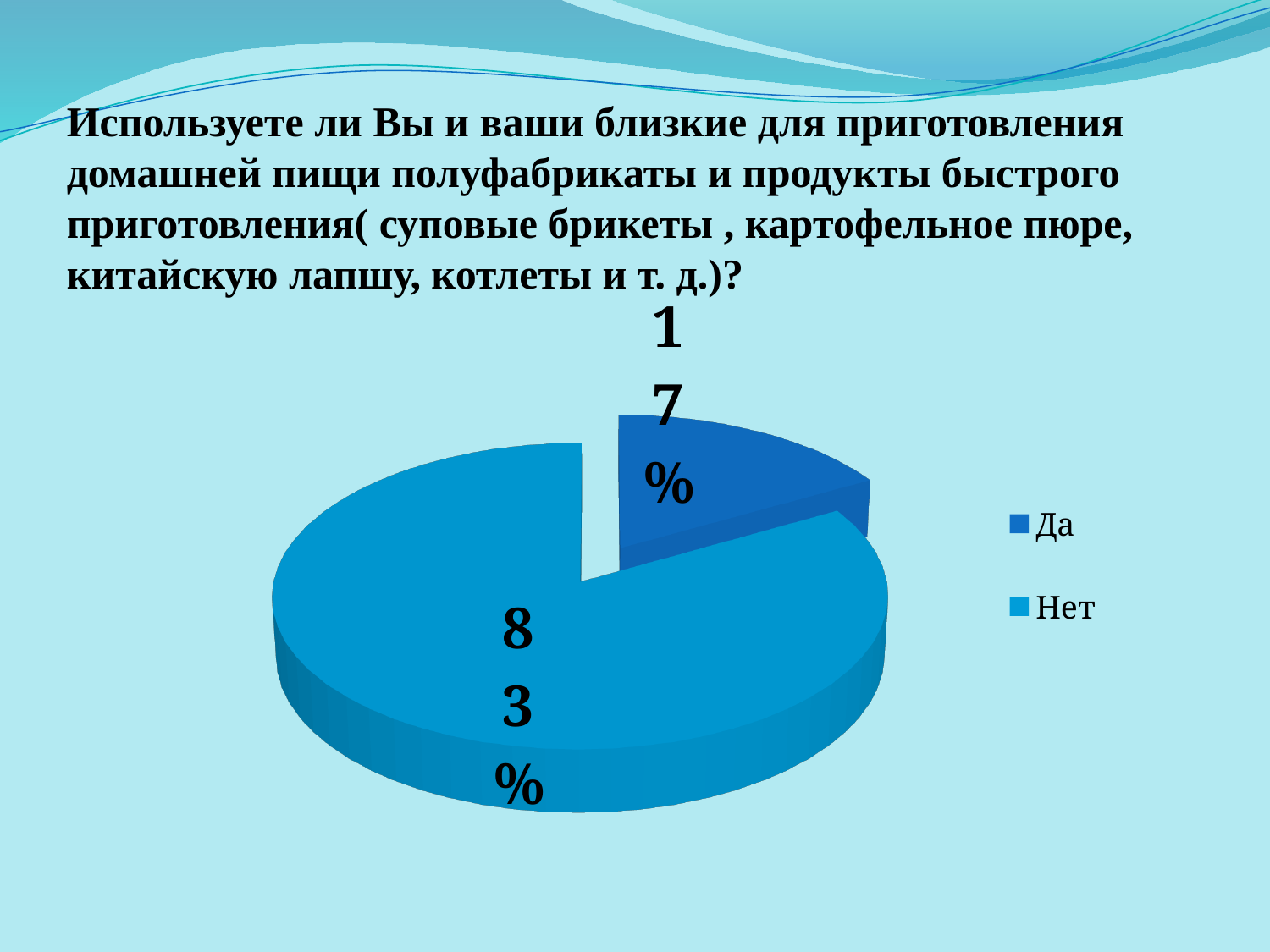
Which legend entry is shown in the darker blue colour? Да How many entries does the legend list? 2 How many slices does the pie chart have? 2 Which slice of the pie is the smallest? Да What is the difference in percentage points between the "Нет" slice and the "Да" slice? 66 What kind of chart is shown on the slide? pie chart What are the two legend entries of the pie chart? Да, Нет What percentage of the pie is labelled for "Да"? 17% What share of the pie does the "Нет" slice represent? 83% Which slice of the pie is the largest? Нет Which is larger, the "Да" slice or the "Нет" slice? Нет What percentage of the pie is labelled for "Нет"? 83%